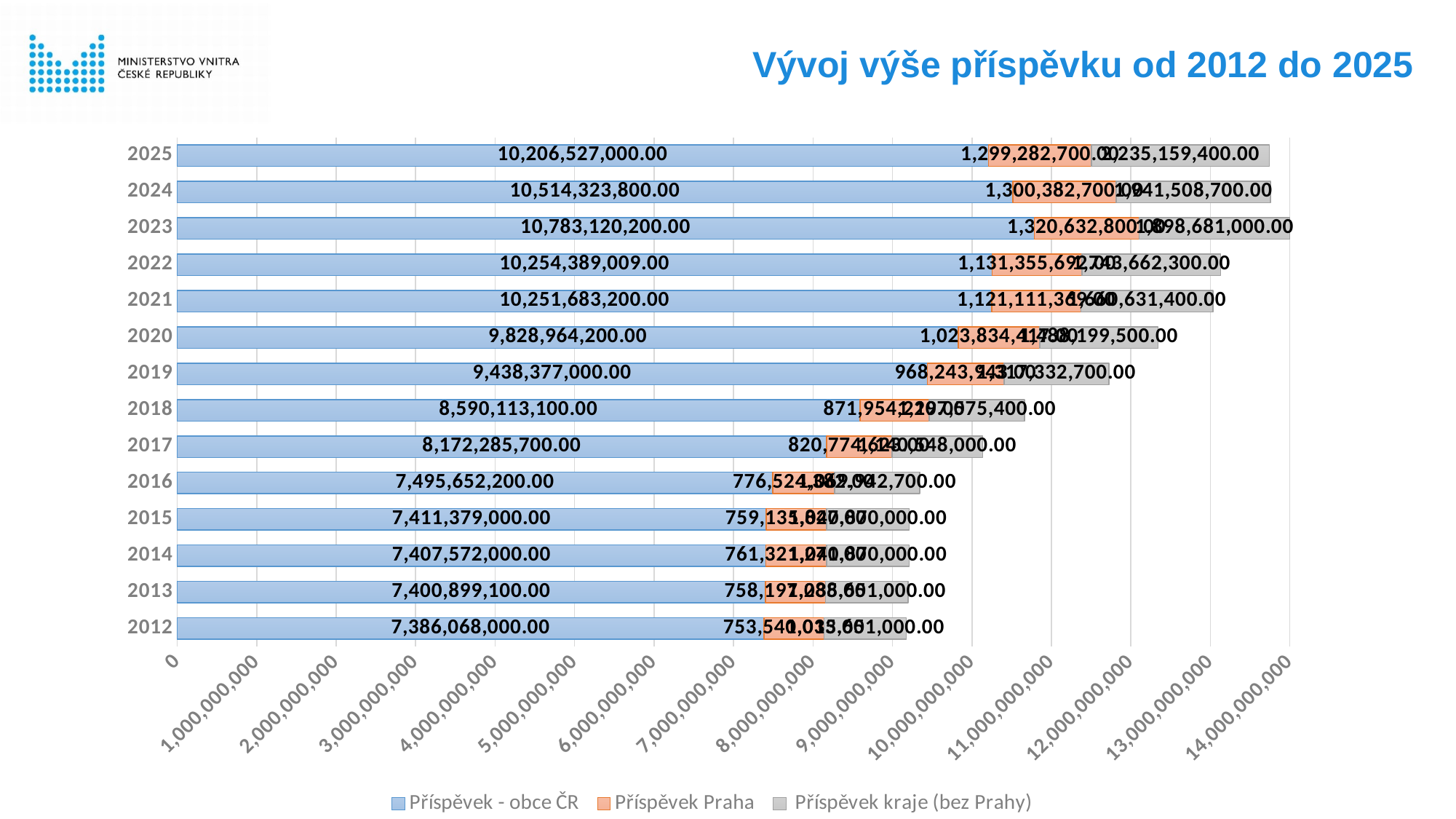
How many series does the legend list? 3 In which year is the Příspěvek - obce ČR value the lowest? 2012 What is the title of the slide? Vývoj výše příspěvku od 2012 do 2025 Which year has the larger Příspěvek - obce ČR value, 2018 or 2020? 2020 What kind of chart is shown on the slide? Stacked bar chart What is the difference between the Příspěvek - obce ČR values for 2023 and 2025? 576,593,200.00 What is the value of Příspěvek - obce ČR for 2019? 9,438,377,000.00 What is the value of Příspěvek - obce ČR for 2025? 10,206,527,000.00 What is the value of Příspěvek - obce ČR for 2012? 7,386,068,000.00 How many years are shown on the chart? 14 In which year is the Příspěvek - obce ČR value the highest? 2023 Is the total length of the stacked bar for 2025 greater or less than 13,000,000,000? greater